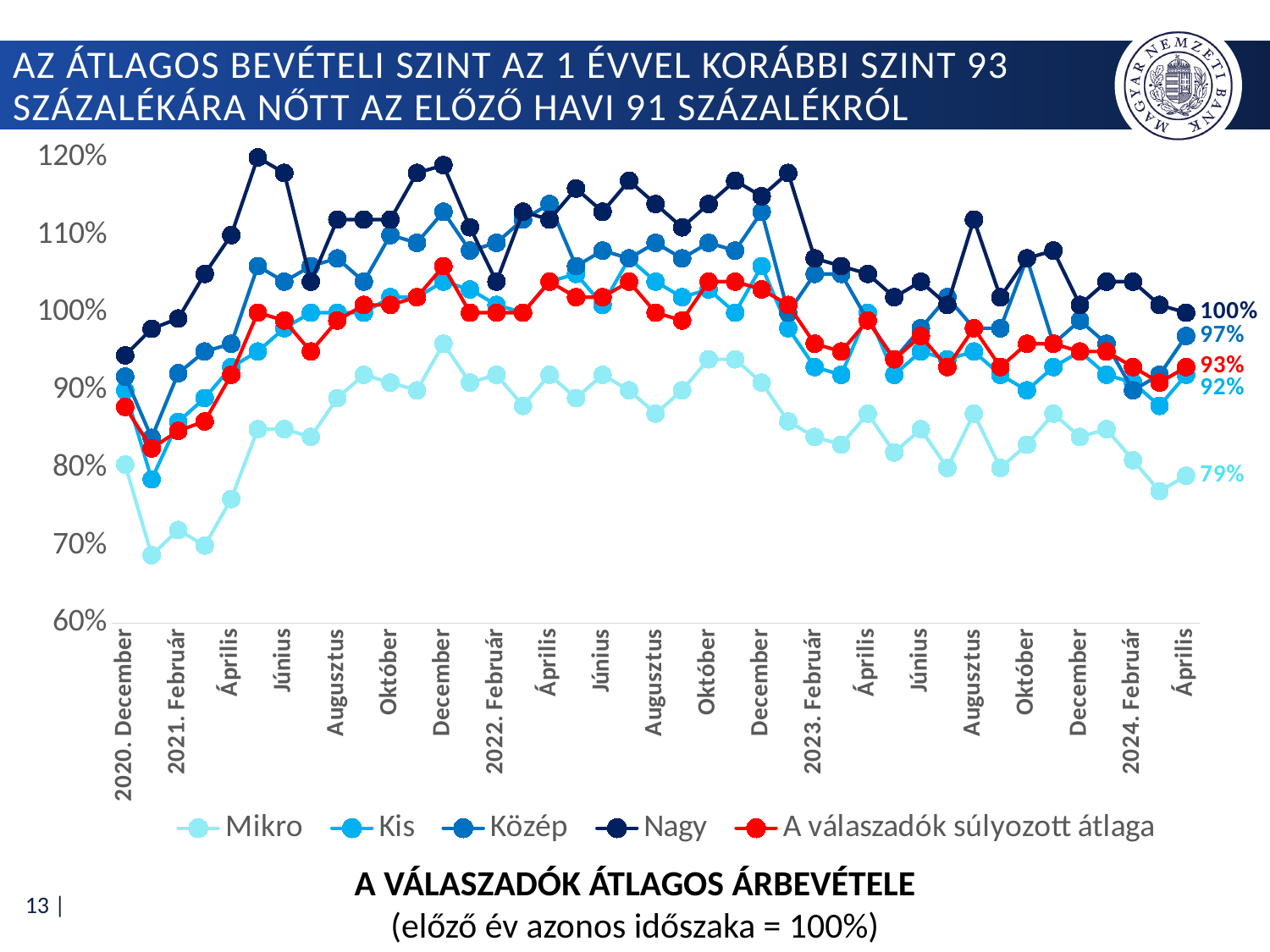
Between 2020 December and 2021 January, does the Mikro series rise or fall? fall What is the final value labelled for the Mikro series at the right end of the chart? 79% How many series does the legend list? 5 What kind of chart is shown on the slide? Line chart What is the final value labelled for the Kis series? 92% Which series has the lowest value at the last data point (2024 April)? Mikro What is the difference between the final labelled values of the Nagy and Mikro series? 21 percentage points What is the final (2024 April) value shown for the Nagy series? 100% Which series has the highest value at the last data point (2024 April)? Nagy At the last data point, which is larger: the Közép value or the Kis value? Közép What is the final value labelled for the series 'A válaszadók súlyozott átlaga'? 93%